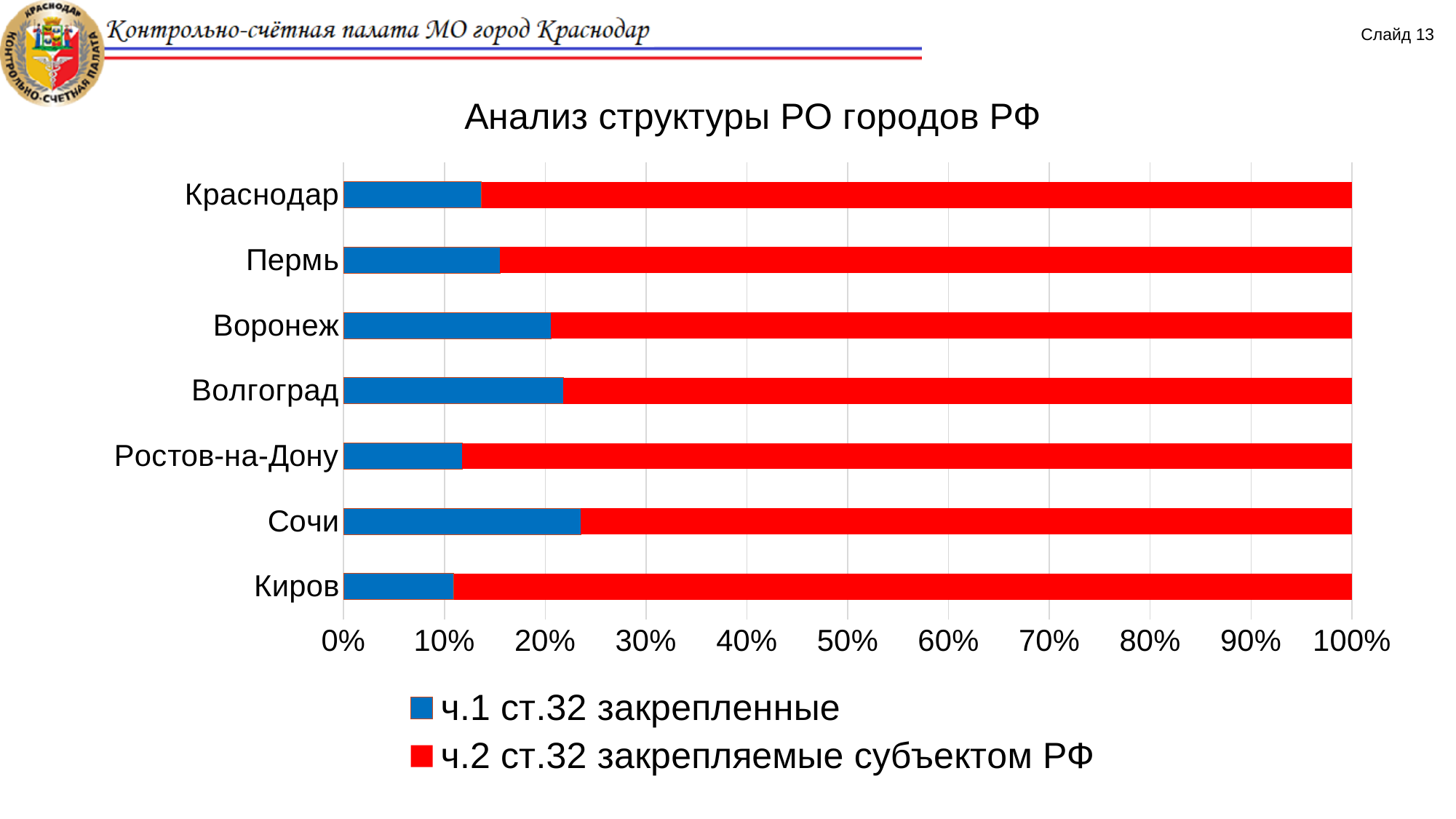
Is the "ч.1 ст.32 закрепленные" share for Киров greater or less than 20%? less Which city has the largest share for "ч.1 ст.32 закрепленные"? Сочи How many series does the legend list? 2 Is the "ч.1 ст.32 закрепленные" share for Пермь greater or less than 20%? less How many cities are listed on the chart? 7 What is the title of the chart? Анализ структуры РО городов РФ Which city has a larger "ч.1 ст.32 закрепленные" share, Сочи or Киров? Сочи Is the "ч.1 ст.32 закрепленные" share for Краснодар greater or less than 20%? less What kind of chart is shown on the slide? Stacked bar chart Which colour represents the series "ч.2 ст.32 закрепляемые субъектом РФ"? Red Which city has a larger "ч.1 ст.32 закрепленные" share, Волгоград or Краснодар? Волгоград